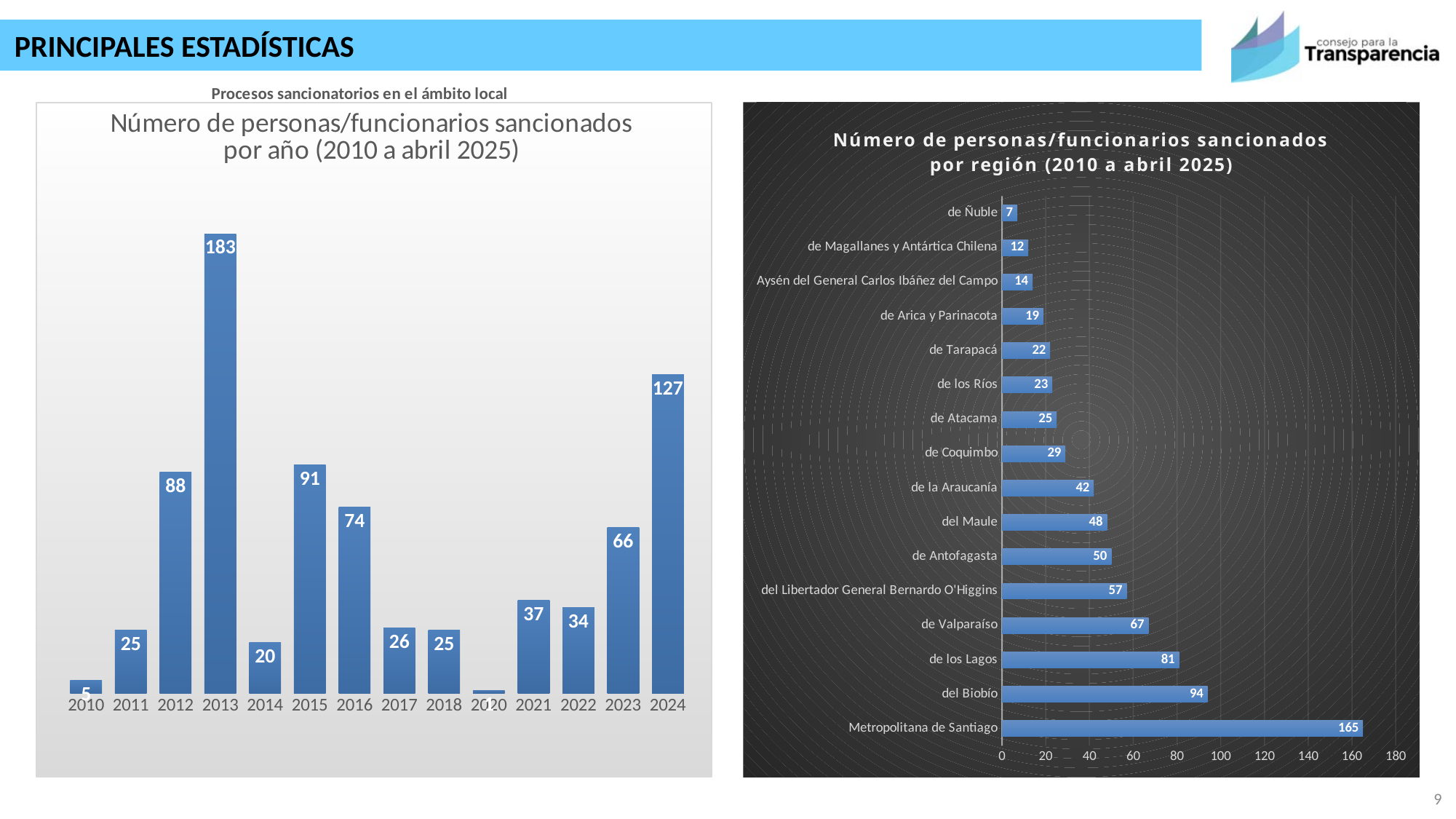
In the chart 'Número de personas/funcionarios sancionados por año (2010 a abril 2025)', which year has the highest value? 2013 In the chart 'Número de personas/funcionarios sancionados por región (2010 a abril 2025)', what is the value for Metropolitana de Santiago? 165 In the chart 'Número de personas/funcionarios sancionados por año (2010 a abril 2025)', what is the value for 2013? 183 In the chart 'Número de personas/funcionarios sancionados por año (2010 a abril 2025)', what is the difference between the values for 2024 and 2023? 61 In the chart 'Número de personas/funcionarios sancionados por región (2010 a abril 2025)', which region has the lowest value? de Ñuble In the chart 'Número de personas/funcionarios sancionados por región (2010 a abril 2025)', which is larger, the value for de Antofagasta or the value for del Maule? de Antofagasta What kind of chart is 'Número de personas/funcionarios sancionados por año (2010 a abril 2025)'? bar chart In the chart 'Número de personas/funcionarios sancionados por año (2010 a abril 2025)', what is the value for 2021? 37 In the chart 'Número de personas/funcionarios sancionados por región (2010 a abril 2025)', what is the difference between the values for del Biobío and de los Lagos? 13 In the chart 'Número de personas/funcionarios sancionados por región (2010 a abril 2025)', what is the value for de Valparaíso? 67 In the chart 'Número de personas/funcionarios sancionados por año (2010 a abril 2025)', which is larger, the value for 2015 or the value for 2012? 2015 How many regions are shown in the chart 'Número de personas/funcionarios sancionados por región (2010 a abril 2025)'? 16